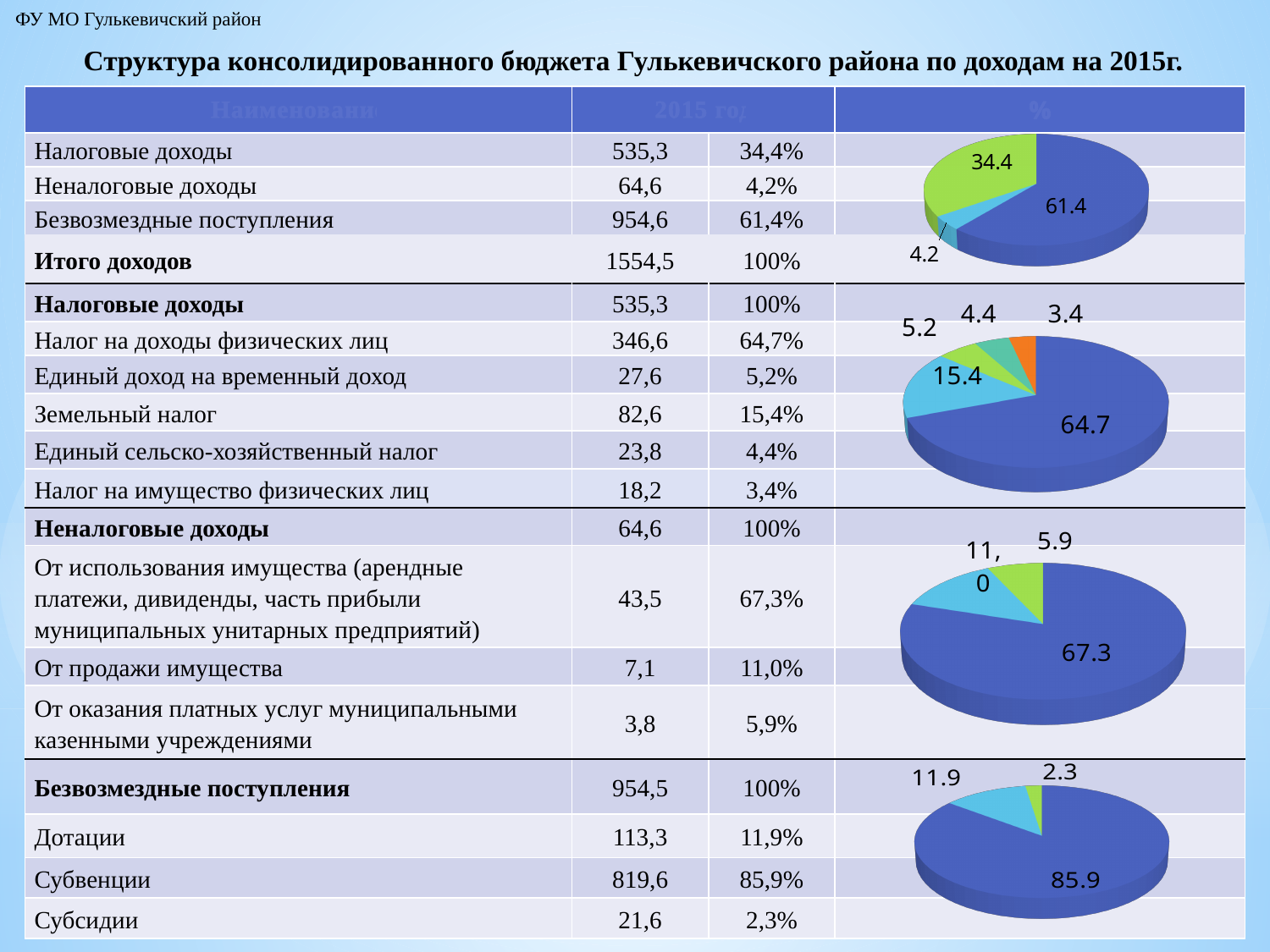
In the second pie chart from the top, what is the value of the largest slice? 64.7 In the top pie chart, what is the value of the largest slice? 61.4 In the second pie chart from the top, what is the difference between the largest slice (64.7) and the slice labelled 15.4? 49.3 In the top pie chart, what is the value of the smallest slice? 4.2 In the bottom pie chart, what is the difference between the slices labelled 11.9 and 2.3? 9.6 How many slices does the second pie chart from the top have? 5 What kind of chart is the top chart on the right side of the slide? pie chart In the third pie chart from the top, what is the value of the smallest slice? 5.9 In the third pie chart from the top, what is the value of the largest slice? 67.3 In the second pie chart from the top, which slice is larger: the one labelled 5.2 or the one labelled 3.4? 5.2 How many slices does the top pie chart have? 3